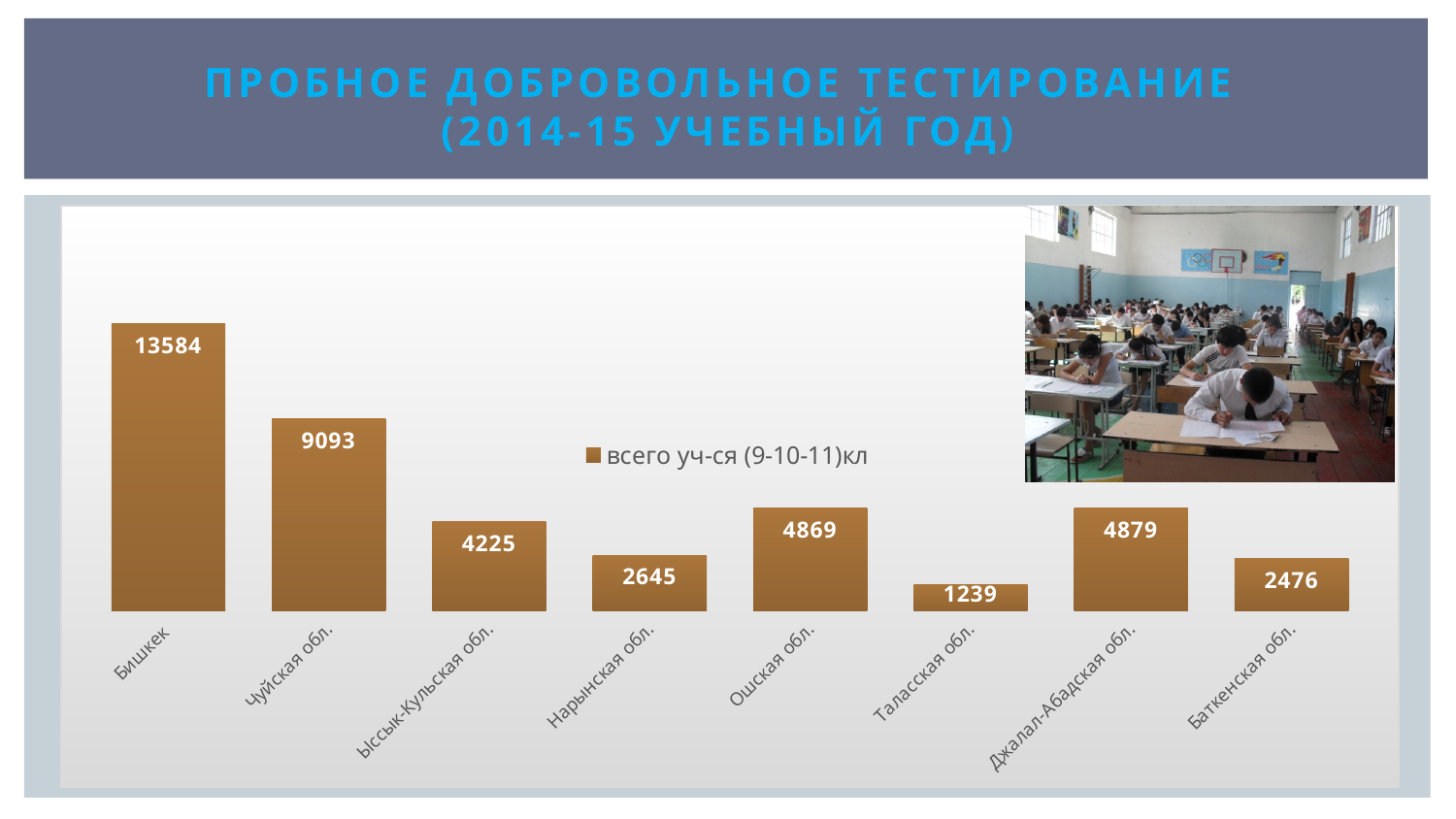
How many categories are shown in the chart? 8 Which category has the highest value? Бишкек What is the value for Таласская обл.? 1239 What is the value for Бишкек? 13584 What is the legend entry of the series shown in the chart? всего уч-ся (9-10-11)кл What is the difference between the values for Бишкек and Чуйская обл.? 4491 What is the value for Чуйская обл.? 9093 What kind of chart is shown on the slide? Bar chart Which is larger, the value for Нарынская обл. or the value for Баткенская обл.? Нарынская обл. Which category has the lowest value? Таласская обл. What is the difference between the values for Ыссык-Кульская обл. and Нарынская обл.? 1580 What is the value for Джалал-Абадская обл.? 4879